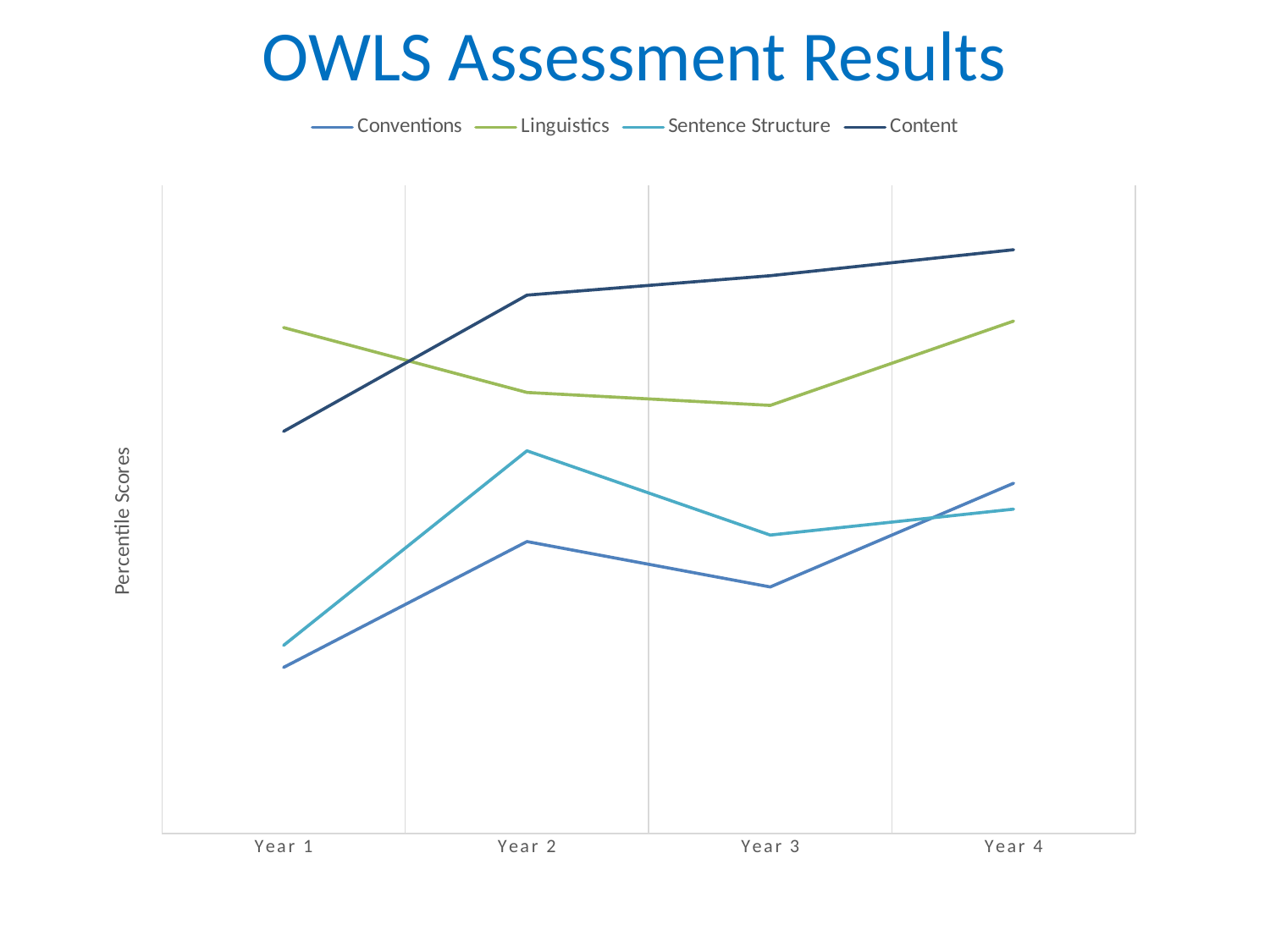
Does the Linguistics series rise or fall from Year 1 to Year 3? fall Which series has the lowest value at Year 1? Conventions At Year 2, which is larger: Sentence Structure or Conventions? Sentence Structure How many years are shown along the x axis? 4 How many series does the legend list? 4 At Year 3, which is larger: Linguistics or Sentence Structure? Linguistics Does the Content series rise or fall from Year 1 to Year 4? rise Which series has the highest value at Year 4? Content Which series has the lowest value at Year 3? Conventions Which series has the highest value at Year 1? Linguistics What is the label on the vertical axis of the chart? Percentile Scores What kind of chart is shown on the slide? line chart